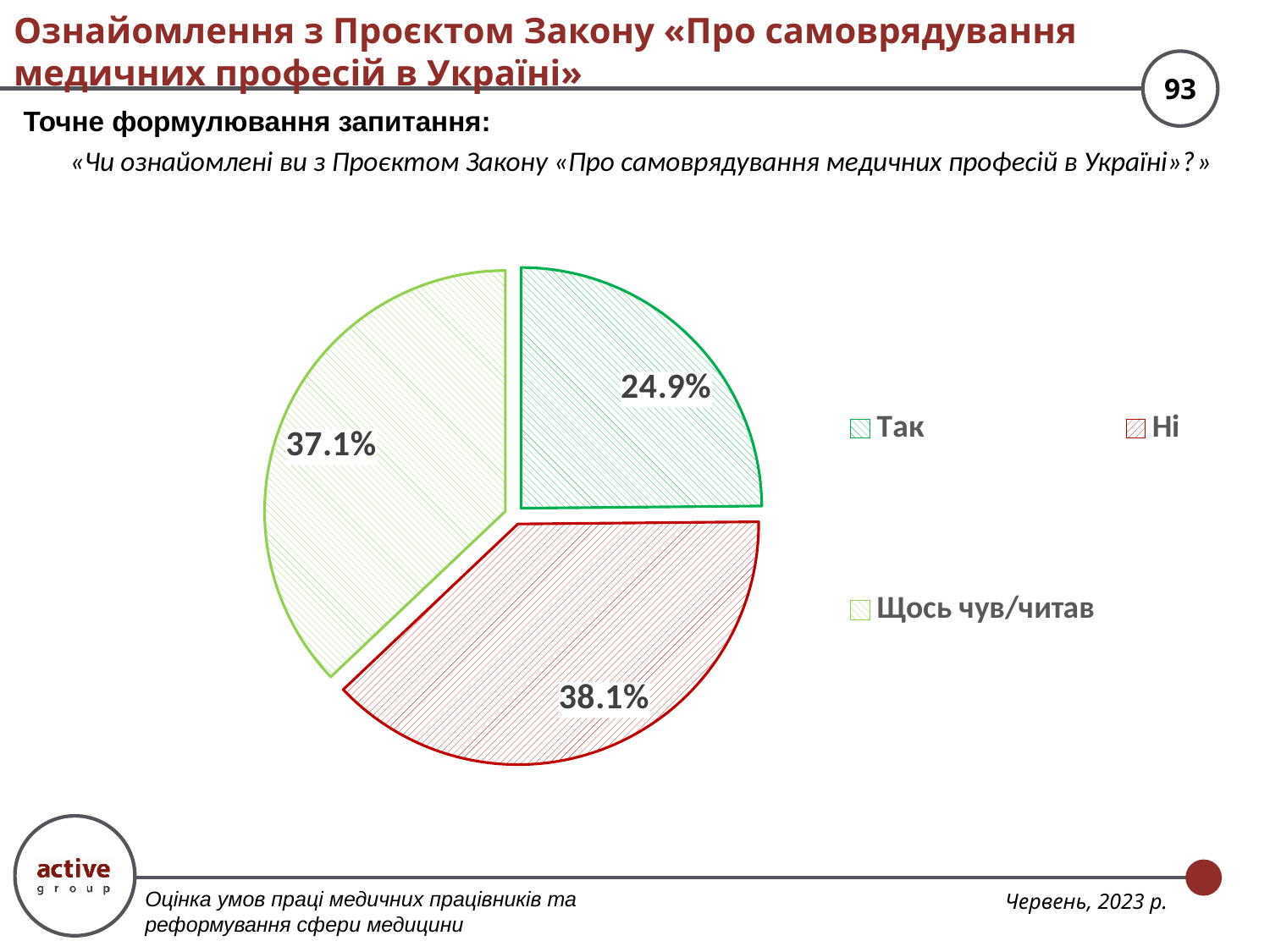
Which is larger, the share for "Щось чув/читав" or the share for "Так"? Щось чув/читав What share of respondents answered "Ні"? 38.1% Which answer has the smallest share of the pie? Так What share of respondents answered "Щось чув/читав"? 37.1% What colour is the slice for "Ні"? red What is the difference in percentage points between "Ні" and "Щось чув/читав"? 1.0 Which answer has the largest share of the pie? Ні What kind of chart is shown on the slide? pie chart What share of respondents answered "Так"? 24.9% How many entries does the legend list? 3 What is the difference in percentage points between "Ні" and "Так"? 13.2 How many slices does the pie chart have? 3